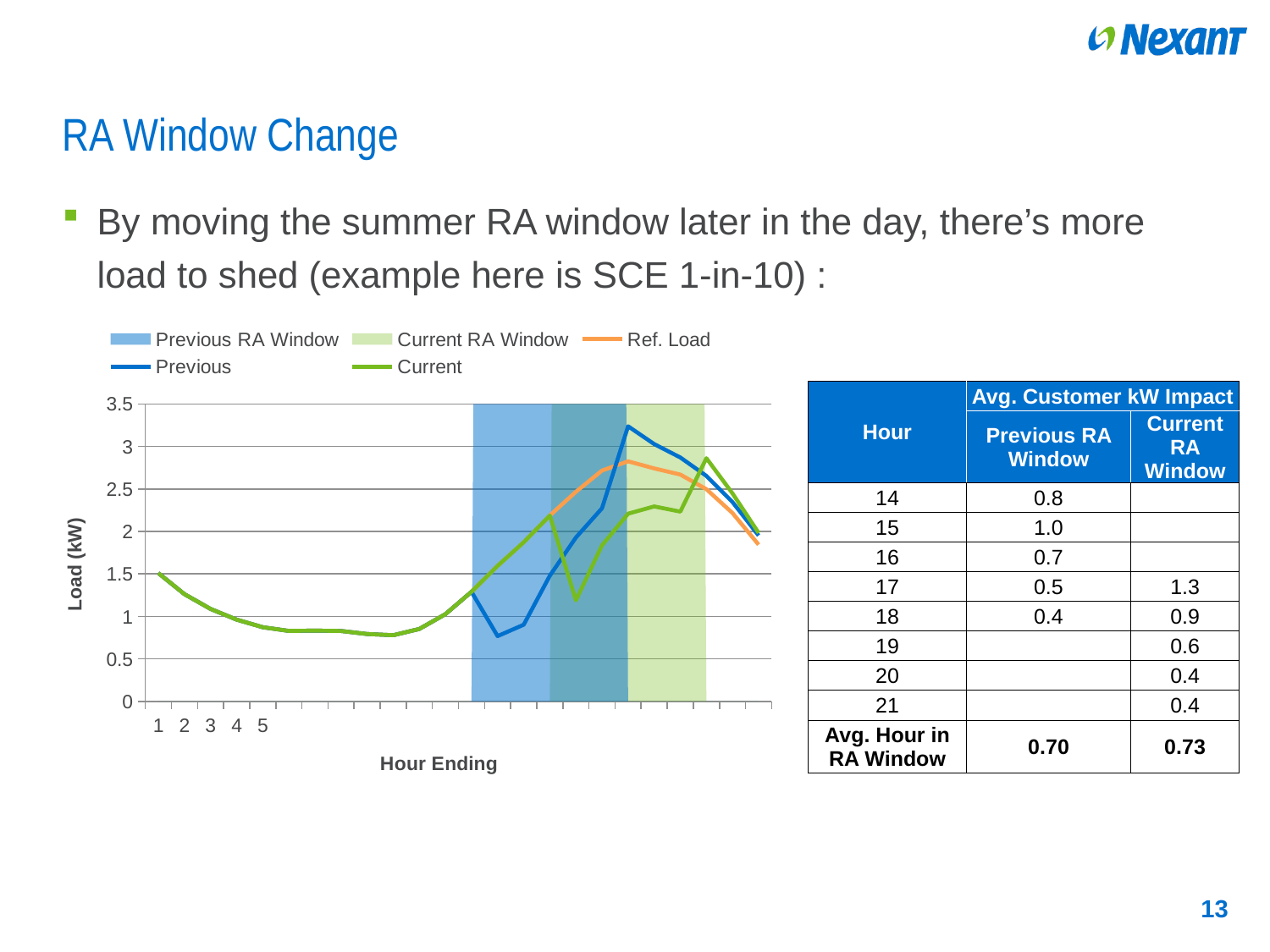
Is the peak value of the Ref. Load line greater or less than 2.5? greater Is the peak value of the Previous line greater or less than 3? greater Is the lowest value of the Current line greater or less than 1? less What is the label on the chart's vertical axis? Load (kW) What is the label on the chart's horizontal axis? Hour Ending How many entries does the chart legend list? 5 What kind of chart is shown on the slide? line chart Which has a higher peak on the chart, the Previous line or the Ref. Load line? Previous Do the load values rise or fall from hour ending 1 to hour ending 5? fall Which line series reaches the highest peak value on the chart? Previous What is the highest value shown on the chart's vertical axis? 3.5